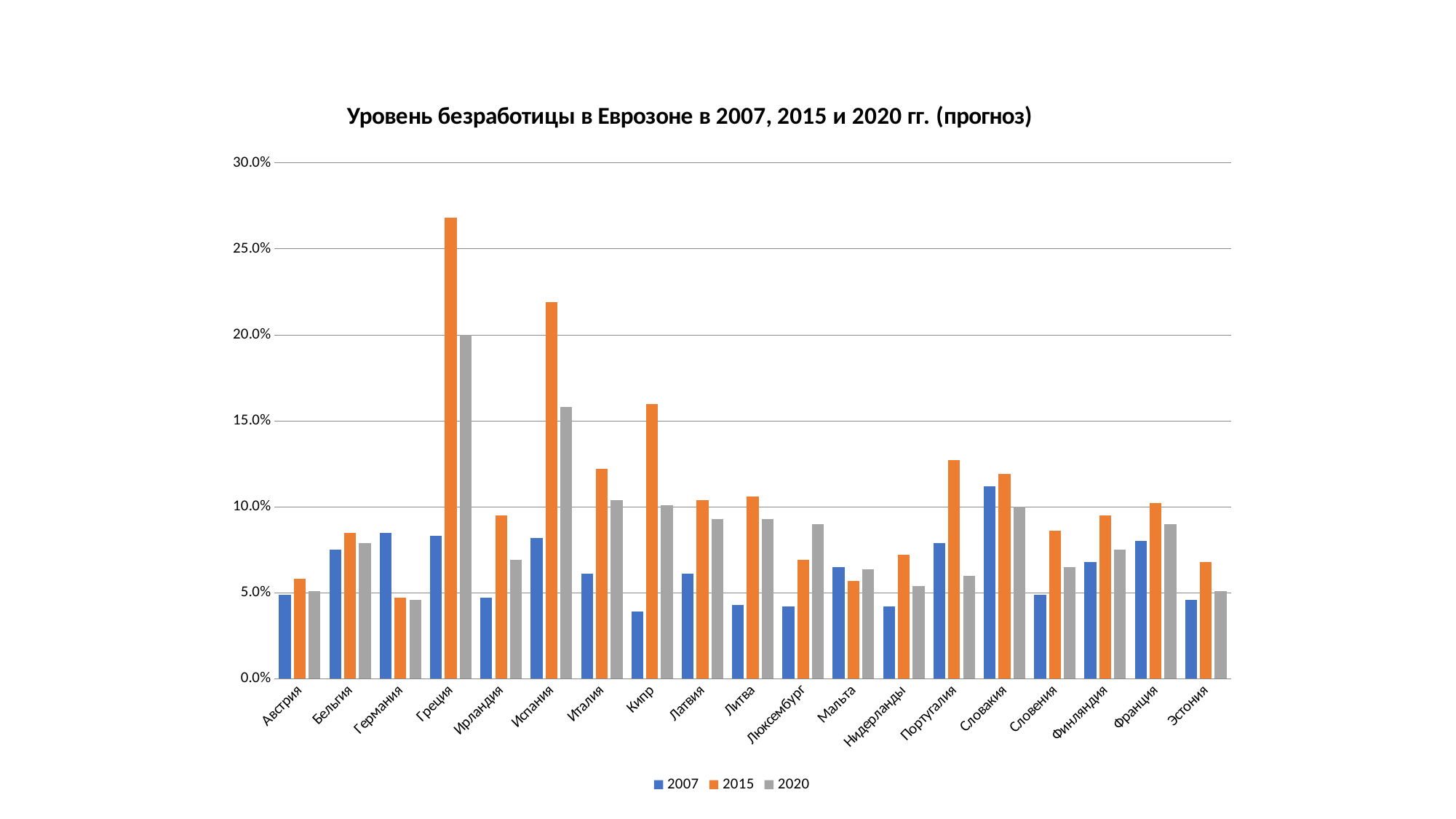
Which country has the highest value for the 2015 series? Греция How many series does the legend list? 3 Is the 2015 value for Греция greater or less than 25.0%? greater Is the 2015 value for Испания greater or less than 20.0%? greater For Германия, which is larger: the 2007 value or the 2015 value? 2007 What is the title of the chart? Уровень безработицы в Еврозоне в 2007, 2015 и 2020 гг. (прогноз) Which is larger for the 2015 series: Испания or Греция? Греция Which country has the highest value for the 2007 series? Словакия What kind of chart is shown on the slide? bar chart How many countries are shown on the x axis? 19 Is the 2015 value for Германия greater or less than 5.0%? less